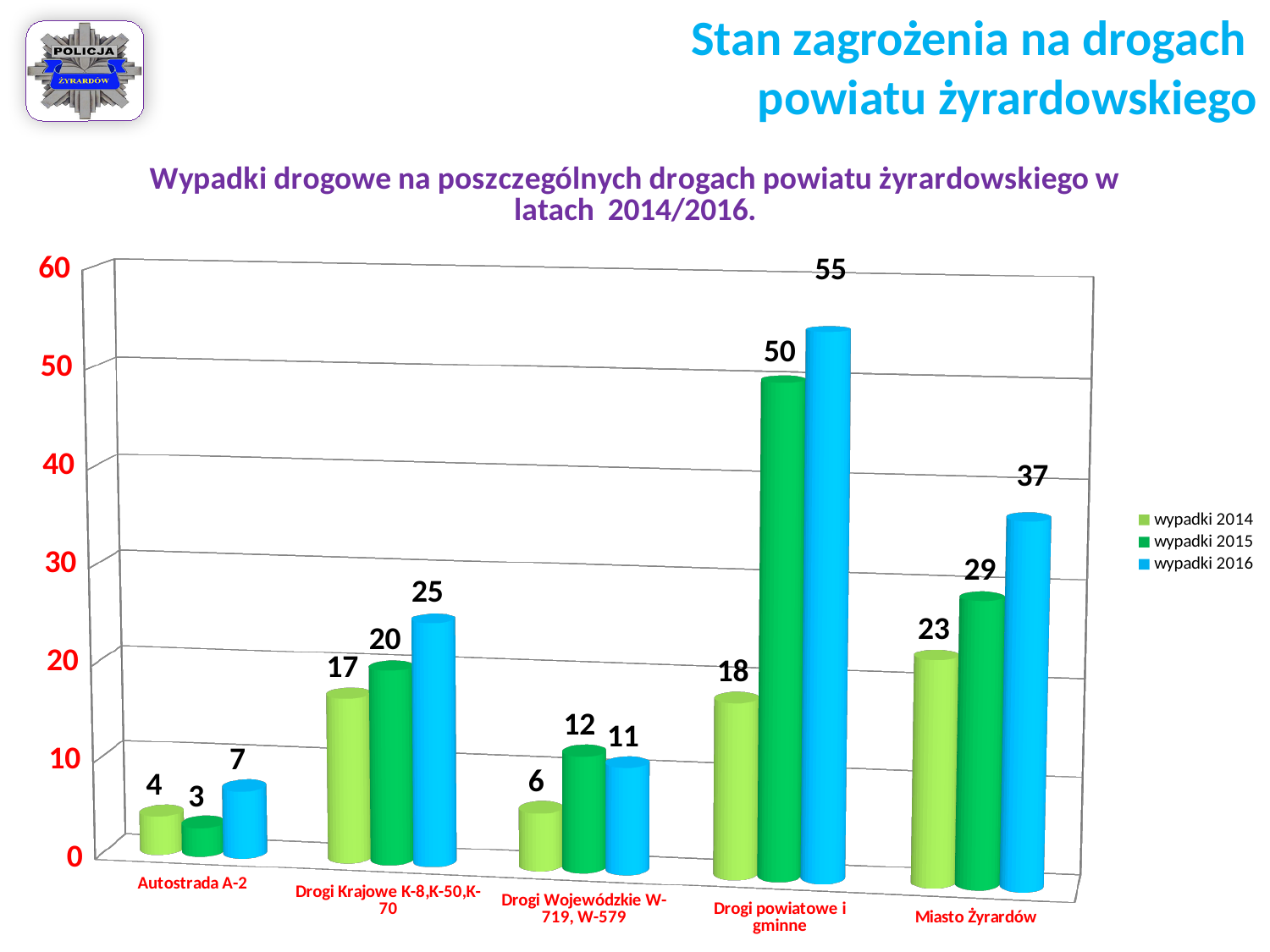
What is the value for wypadki 2015 for Miasto Żyrardów? 29 What kind of chart is shown on the slide? bar chart What is the value for wypadki 2014 for Autostrada A-2? 4 How many series does the legend list? 3 Which category has the highest value for wypadki 2016? Drogi powiatowe i gminne Which is larger for Drogi Wojewódzkie W-719, W-579: wypadki 2015 or wypadki 2016? wypadki 2015 What is the difference between wypadki 2016 and wypadki 2014 for Miasto Żyrardów? 14 Do the values for Drogi Krajowe K-8,K-50,K-70 rise or fall from wypadki 2014 to wypadki 2016? rise What colour are the bars for wypadki 2016? blue How many categories are shown on the x axis? 5 Which category has the lowest value for wypadki 2015? Autostrada A-2 What is the value for wypadki 2016 for Drogi powiatowe i gminne? 55